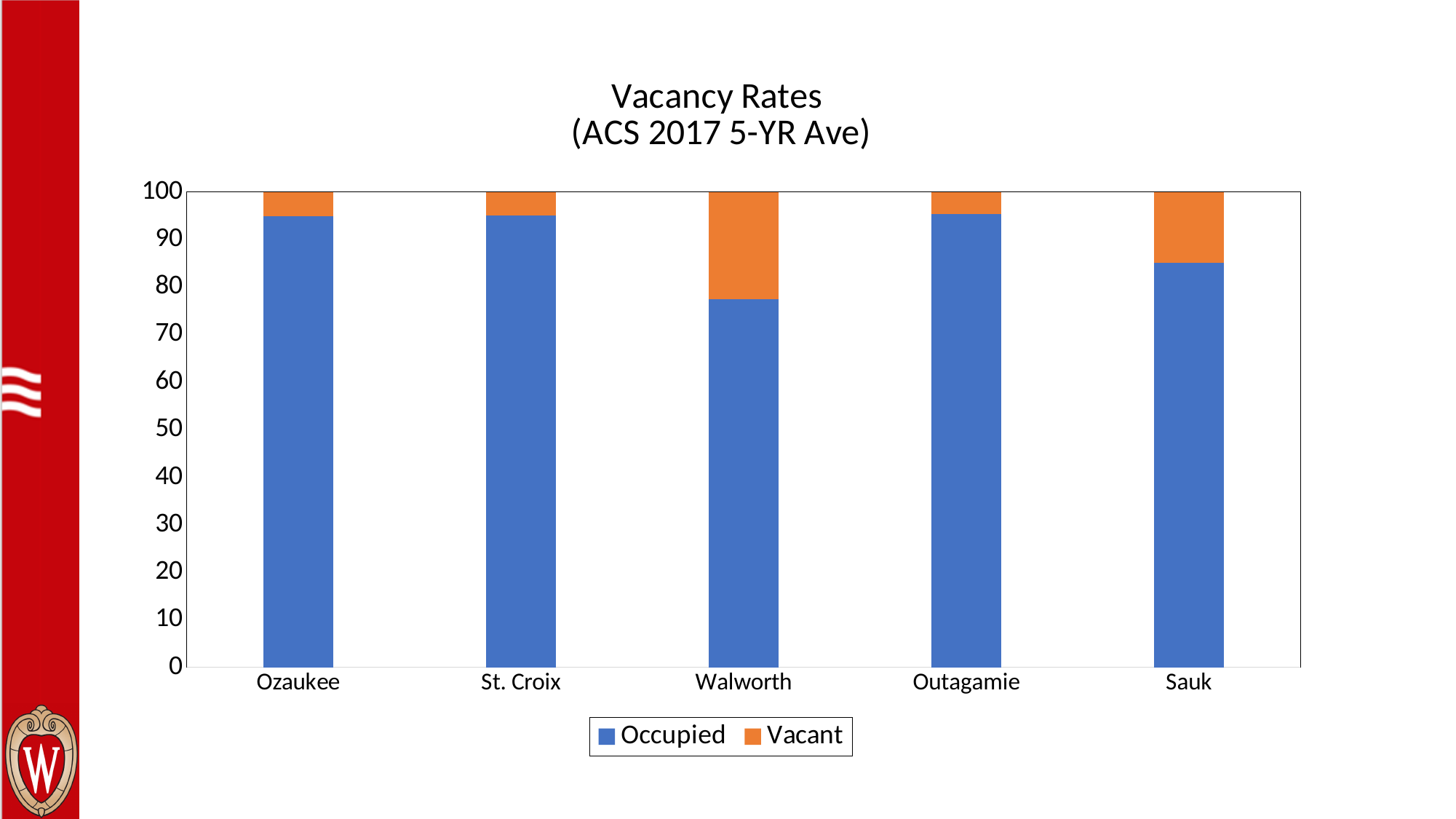
What is the title of the chart? Vacancy Rates (ACS 2017 5-YR Ave) How many series does the legend list? 2 Is the Vacant value for Sauk greater or less than 10? greater How many counties are shown on the x axis of the chart? 5 Which county has the lowest Occupied value? Walworth Which county has the highest Vacant value? Walworth Is the Occupied value for Sauk greater or less than 80? greater Is the Occupied value for Walworth greater or less than 80? less Which is larger, the Vacant value for Walworth or the Vacant value for Sauk? Walworth What kind of chart is shown on the slide? bar chart What is the total height of the stacked bar for Outagamie? 100